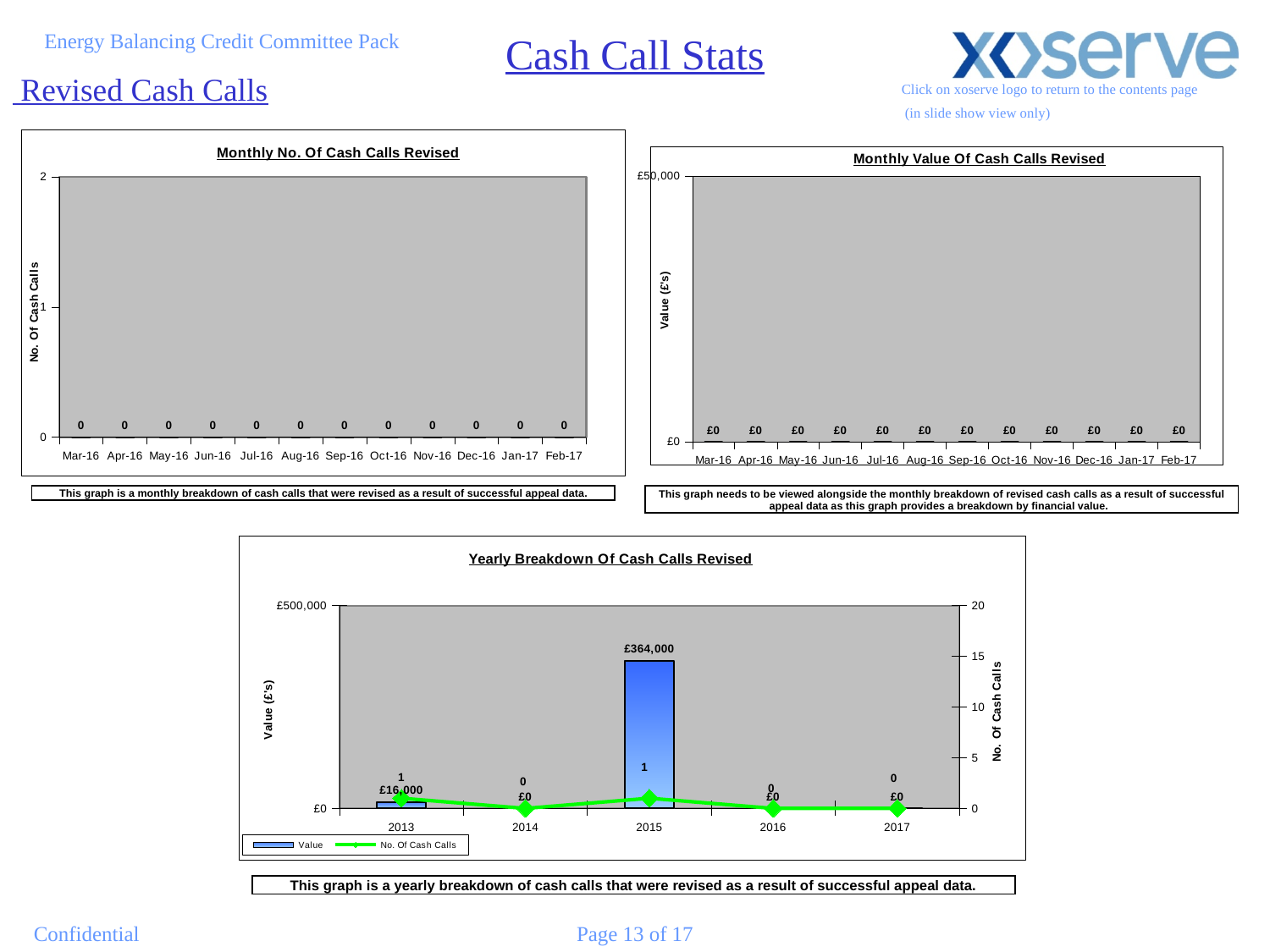
In the 'Yearly Breakdown Of Cash Calls Revised' chart, how many years are shown on the x axis? 5 In the 'Yearly Breakdown Of Cash Calls Revised' chart, what is the Value for 2015? £364,000 In the 'Yearly Breakdown Of Cash Calls Revised' chart, what is the No. Of Cash Calls for 2016? 0 In the 'Yearly Breakdown Of Cash Calls Revised' chart, is the Value for 2013 larger or smaller than the Value for 2015? smaller In the 'Monthly No. Of Cash Calls Revised' chart, how many months are shown on the x axis? 12 In the 'Yearly Breakdown Of Cash Calls Revised' chart, which year has the highest Value? 2015 In the 'Yearly Breakdown Of Cash Calls Revised' chart, what is the Value for 2013? £16,000 What type of chart is the 'Monthly Value Of Cash Calls Revised' chart? bar chart In the 'Yearly Breakdown Of Cash Calls Revised' chart, how many series does the legend list? 2 In the 'Monthly Value Of Cash Calls Revised' chart, what is the value for Dec-16? £0 In the 'Monthly No. Of Cash Calls Revised' chart, what is the value for Jul-16? 0 In the 'Yearly Breakdown Of Cash Calls Revised' chart, what is the difference in Value between 2015 and 2013? £348,000